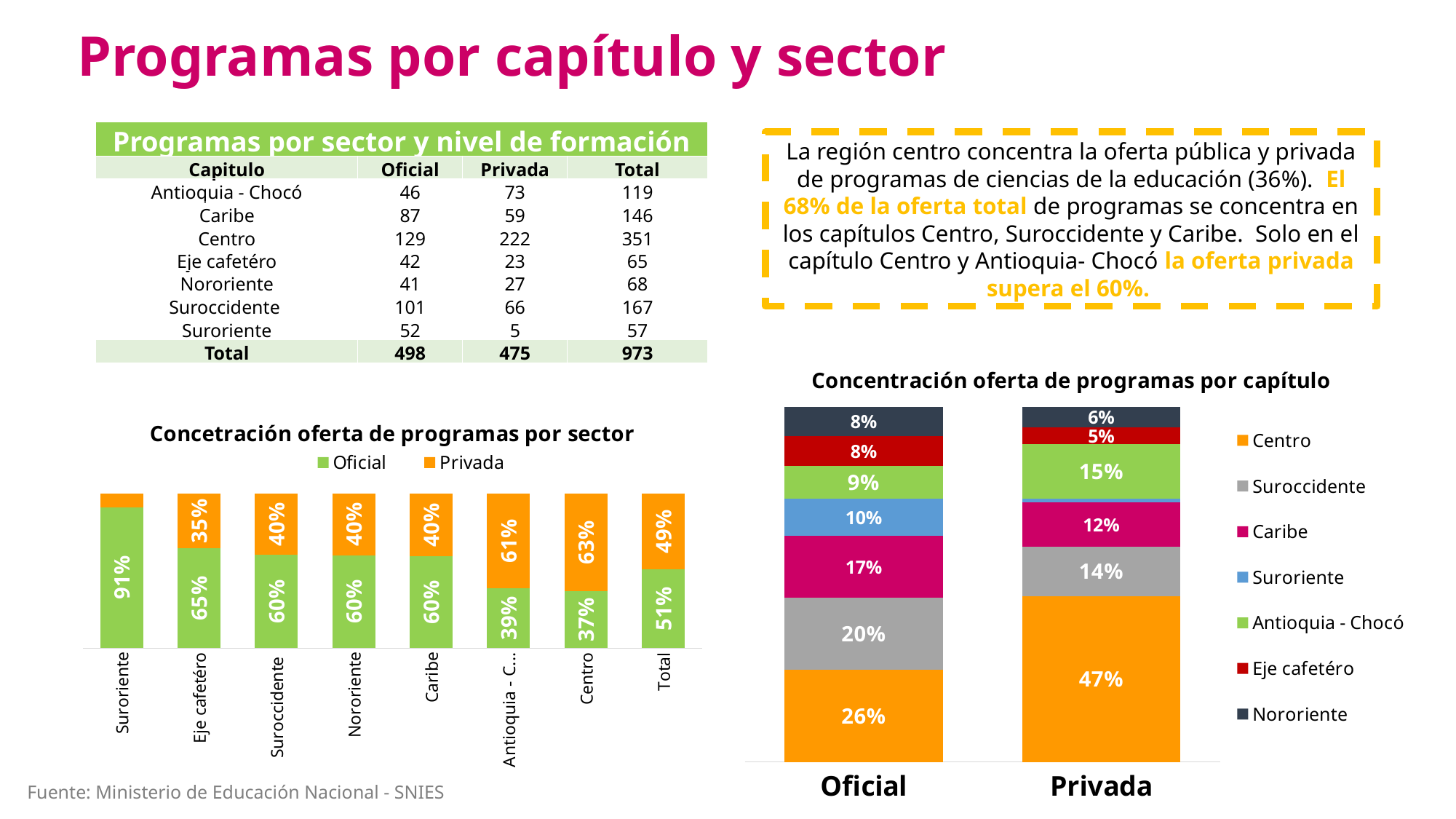
In the chart 'Concentración oferta de programas por capítulo', is the Caribe share larger in the Oficial bar or the Privada bar? Oficial What type of chart is 'Concentración oferta de programas por capítulo'? Stacked bar chart In the chart 'Concentración oferta de programas por capítulo', which capítulo has the largest share of the Oficial bar? Centro In the chart 'Concentración oferta de programas por capítulo', how many capítulos does the legend list? 7 In the chart 'Concetración oferta de programas por sector', how many categories are shown on the x axis? 8 In the chart 'Concetración oferta de programas por sector', which category has the lowest Oficial share? Centro In the chart 'Concentración oferta de programas por capítulo', what is the Centro share of the Privada bar? 47% In the chart 'Concetración oferta de programas por sector', what is the Privada value for Centro? 63% In the chart 'Concentración oferta de programas por capítulo', what is the Suroccidente share of the Oficial bar? 20% In the chart 'Concetración oferta de programas por sector', what is the Oficial value for Suroriente? 91% In the chart 'Concetración oferta de programas por sector', how many series does the legend list? 2 In the chart 'Concetración oferta de programas por sector', what is the difference between the Privada value for Centro and the Privada value for Eje cafetéro? 28%